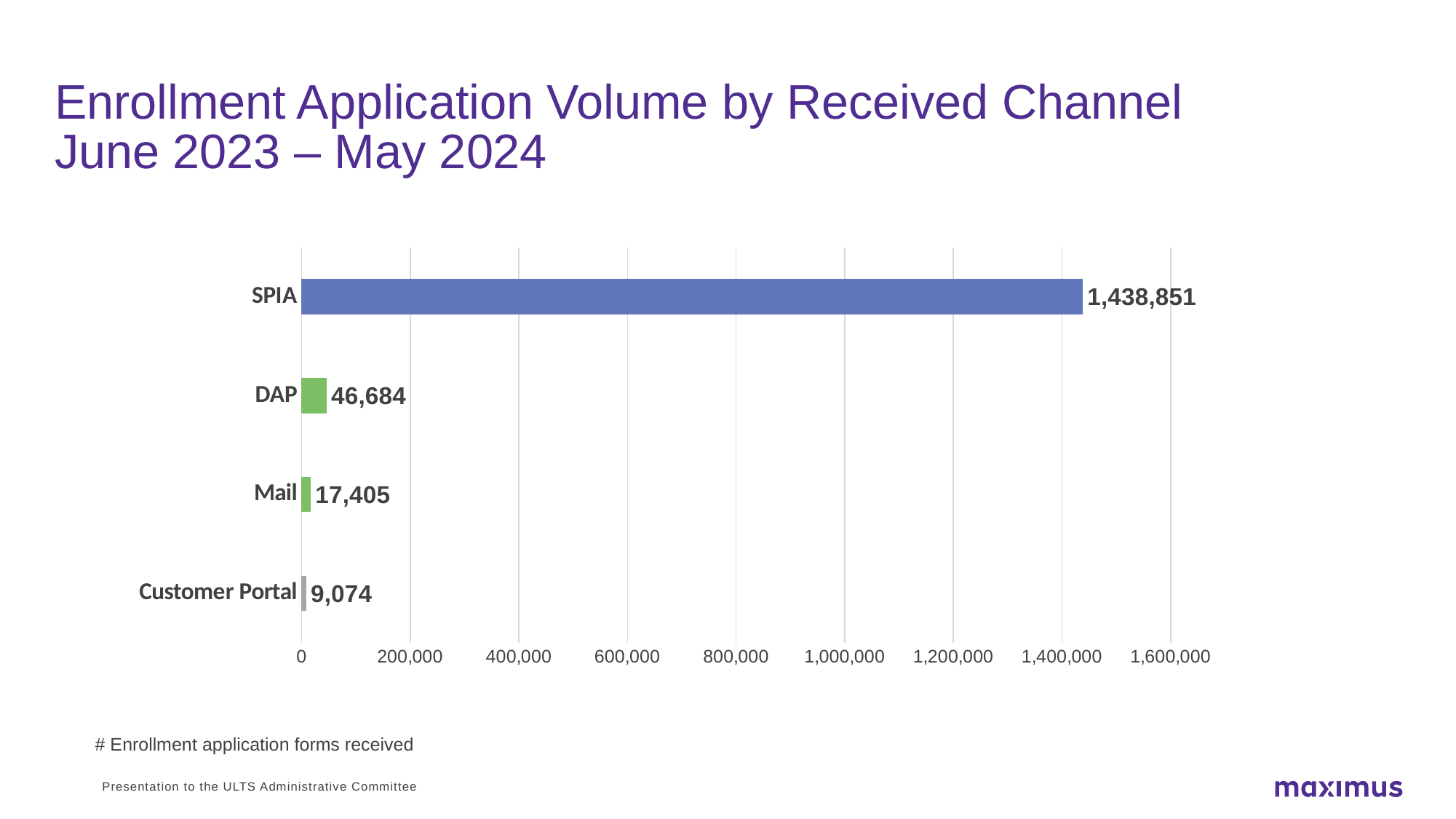
What is the enrollment application volume for SPIA? 1,438,851 What is the difference between the Mail and Customer Portal volumes? 8,331 Which channel has the lowest enrollment application volume? Customer Portal What is the enrollment application volume for Customer Portal? 9,074 Which channel has a larger volume, DAP or Mail? DAP What is the enrollment application volume for DAP? 46,684 What is the enrollment application volume for Mail? 17,405 What kind of chart is shown on the slide? Bar chart Which channel has the highest enrollment application volume? SPIA How many channels are shown in the chart? 4 What is the difference between the DAP and Mail volumes? 29,279 Is the value for SPIA greater or less than 1,400,000? greater